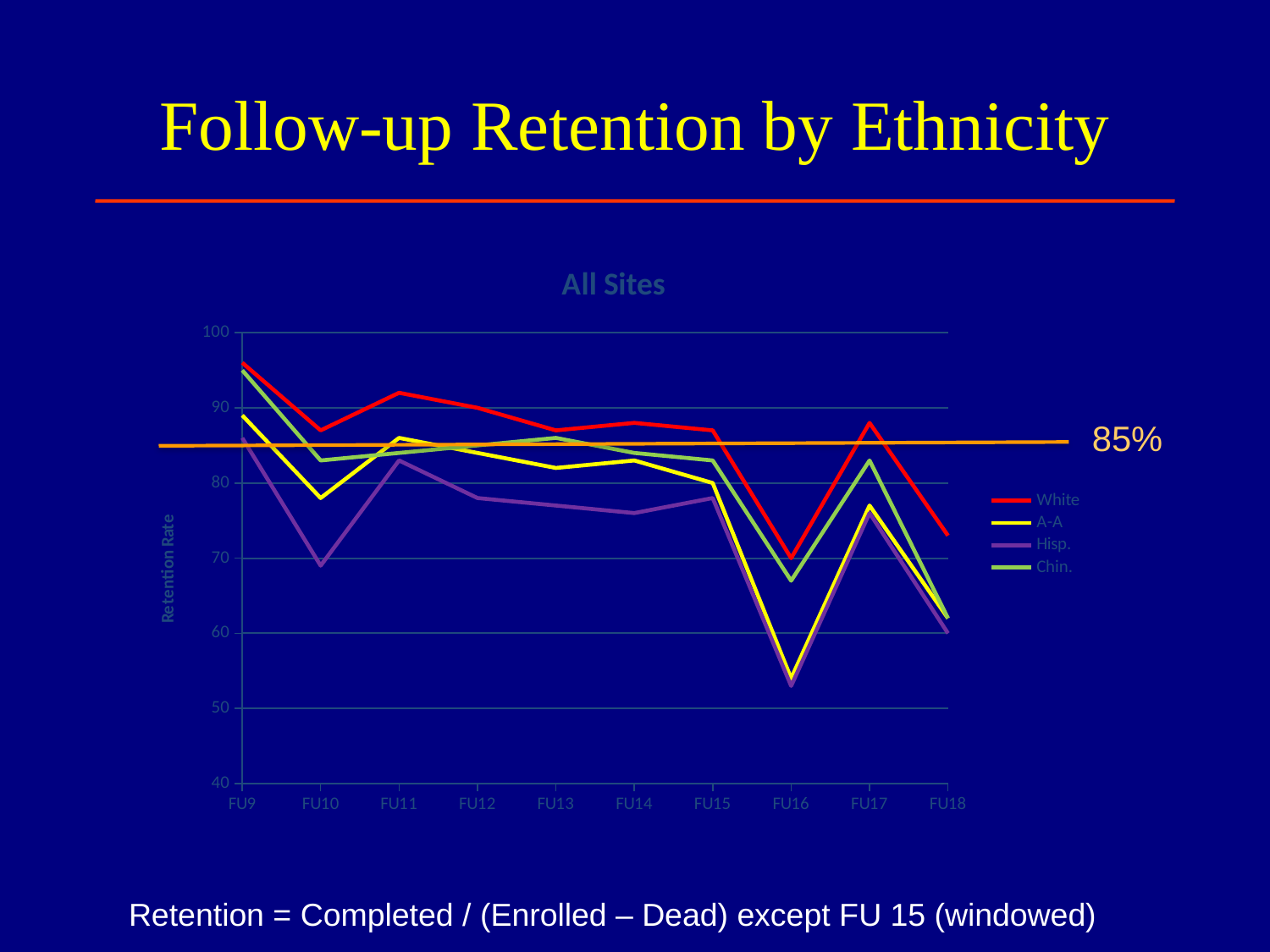
What is the title of the chart? All Sites Does the White series overall rise or fall from FU9 to FU18? fall Is the value for Chin. at FU16 greater or less than 70? less How many series does the legend list? 4 Is the value for A-A at FU16 greater or less than 60? less Is the value for A-A at FU10 greater or less than 80? less At FU16, which is higher, White or A-A? White Which series has the lowest value at FU10? Hisp. How many follow-up points are plotted along the x axis? 10 What value does the horizontal orange reference line mark? 85% What kind of chart is shown on the slide? line chart